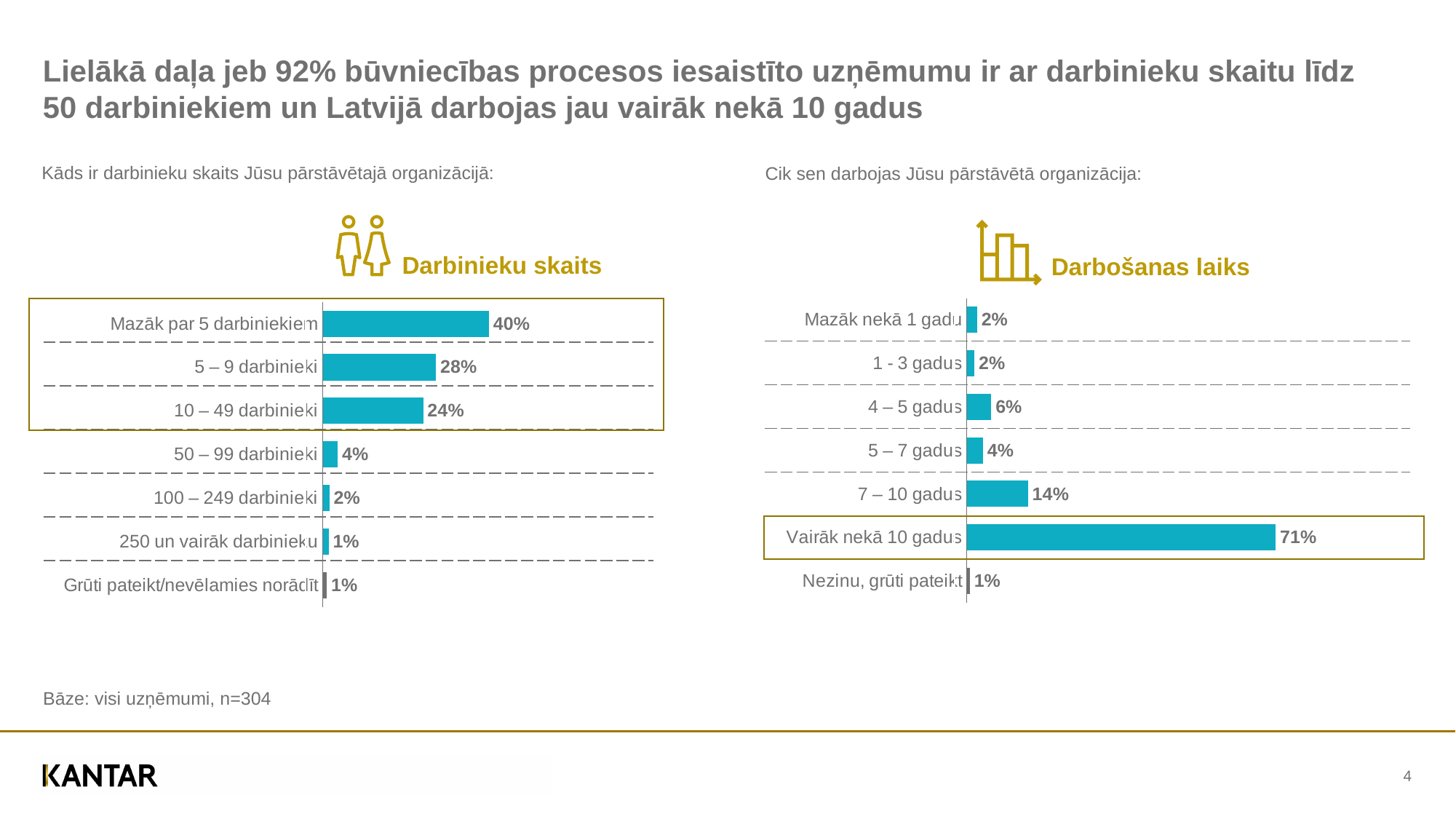
In the 'Darbošanas laiks' chart, what is the difference between 'Vairāk nekā 10 gadus' and '7 – 10 gadus'? 57% In the 'Darbošanas laiks' chart, which category has the lowest value? Nezinu, grūti pateikt In the 'Darbošanas laiks' chart, how many categories are shown? 7 In the 'Darbinieku skaits' chart, what is the value for 'Mazāk par 5 darbiniekiem'? 40% In the 'Darbinieku skaits' chart, how many categories are shown? 7 In the 'Darbinieku skaits' chart, which category has the highest value? Mazāk par 5 darbiniekiem What type of chart is the 'Darbinieku skaits' chart? Bar chart In the 'Darbošanas laiks' chart, which is larger: '4 – 5 gadus' or '5 – 7 gadus'? 4 – 5 gadus In the 'Darbinieku skaits' chart, what is the difference between '5 – 9 darbinieki' and '50 – 99 darbinieki'? 24% In the 'Darbošanas laiks' chart, what is the value for '7 – 10 gadus'? 14% In the 'Darbinieku skaits' chart, what is the value for '10 – 49 darbinieki'? 24% In the 'Darbošanas laiks' chart, what is the value for 'Vairāk nekā 10 gadus'? 71%